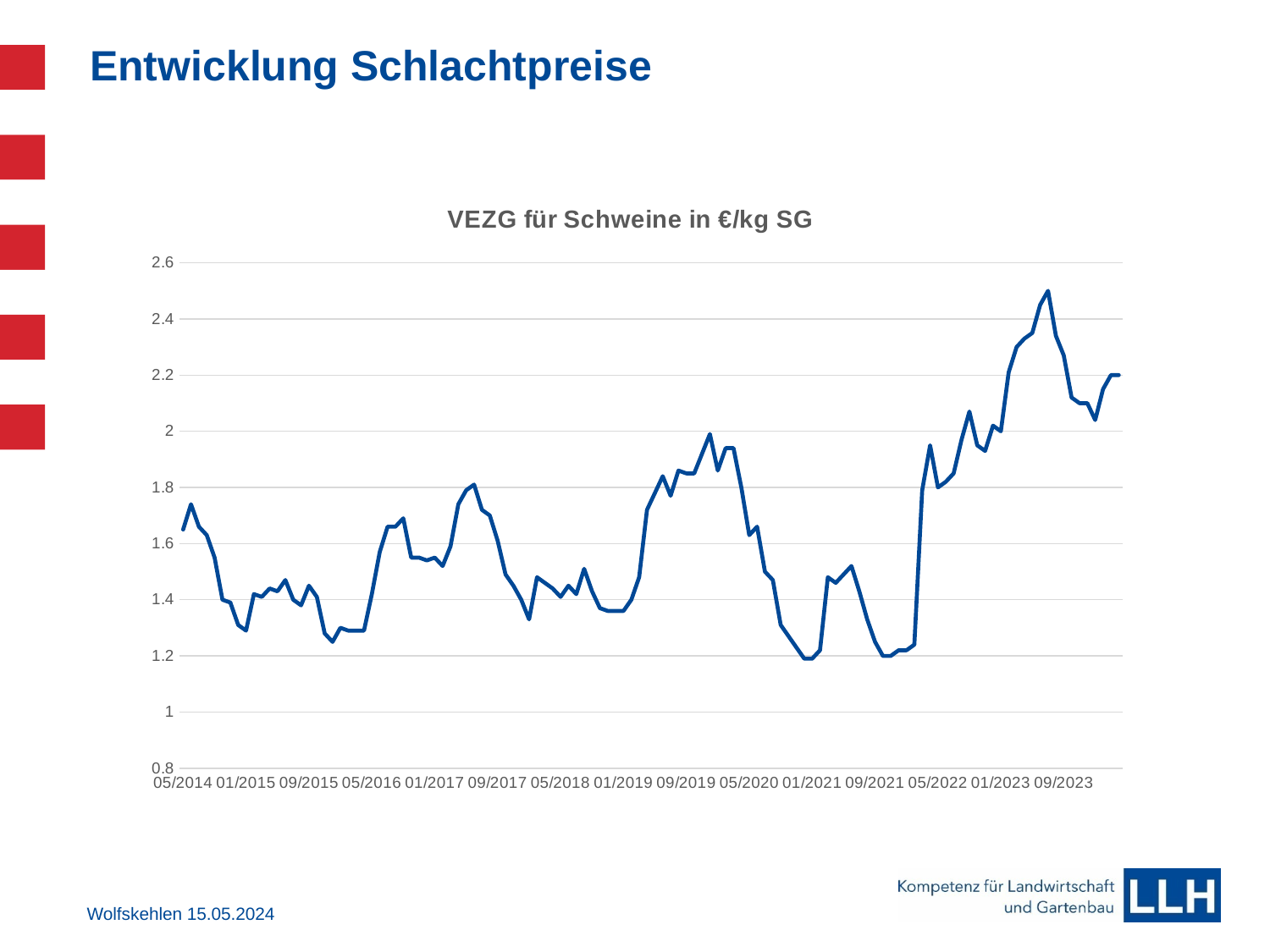
Is the value for 01/2017 greater or less than 1.8? less Does the line rise or fall between 05/2014 and 09/2015? fall How many lines are plotted in the chart? 1 Is the highest value on the line greater or less than 2.4? greater Does the line rise or fall between 09/2021 and 01/2023? rise What is the title of the chart? VEZG für Schweine in €/kg SG What kind of chart is shown on the slide? line chart Is the value for 05/2014 greater or less than 1.4? greater What is the highest value shown on the y axis? 2.6 Which is larger, the value for 01/2023 or the value for 01/2015? 01/2023